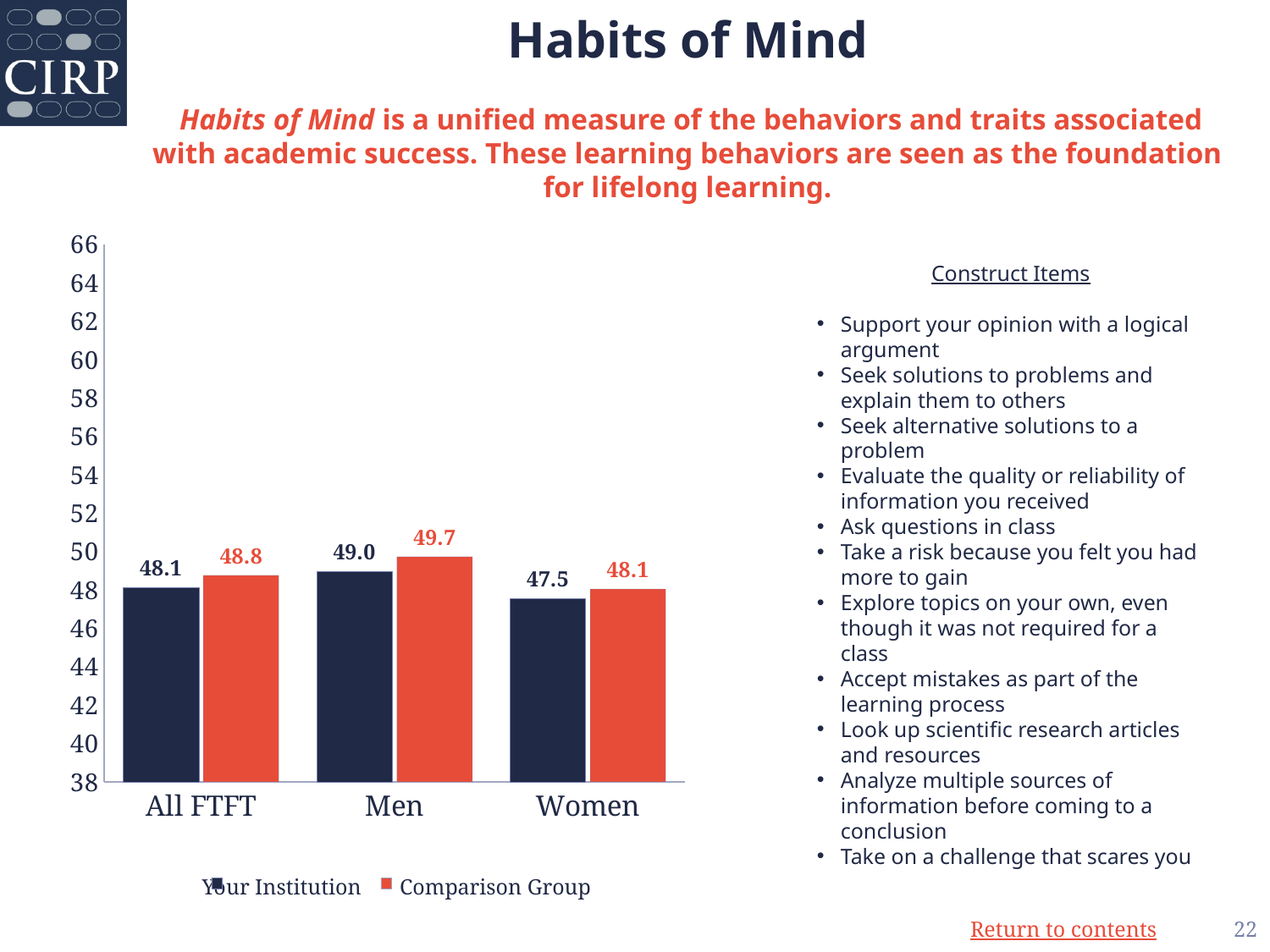
What is the value for Your Institution in the All FTFT category? 48.1 What is the difference between the Comparison Group and Your Institution values in the Men category? 0.7 What is the value for Your Institution in the Women category? 47.5 In the All FTFT category, which is larger: Your Institution or the Comparison Group? Comparison Group What kind of chart is shown on the slide? bar chart Which category has the lowest value for the Comparison Group? Women How many categories are shown on the x axis? 3 Which category has the highest value for Your Institution? Men How many series does the legend list? 2 What is the value for the Comparison Group in the Women category? 48.1 What is the value for the Comparison Group in the Men category? 49.7 Is the value for Your Institution in the Women category greater or less than 50? less